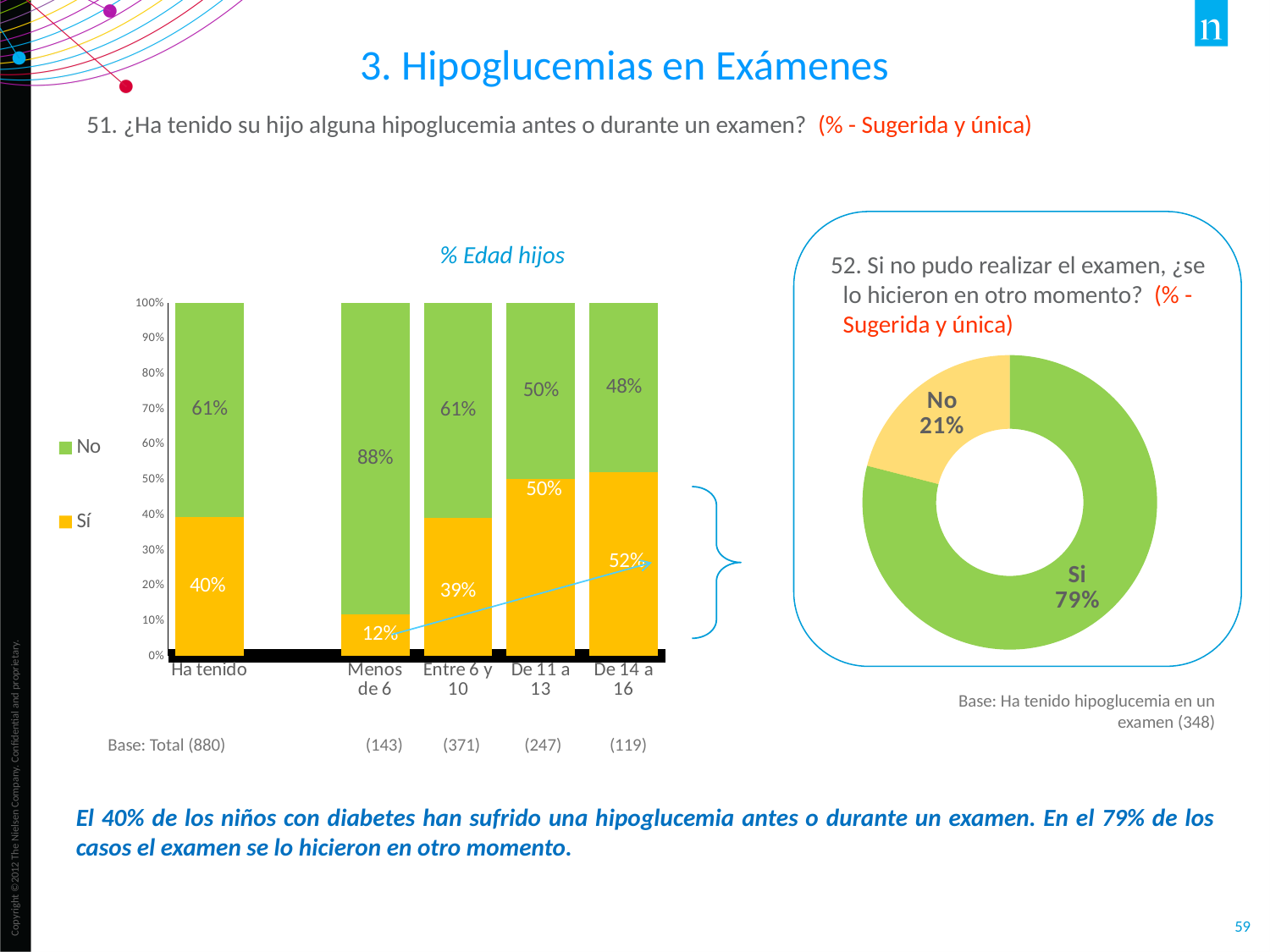
In the donut chart on the right, what share does 'Si' have? 79% In the stacked bar chart on the left, what is the difference between the 'Sí' values for 'De 14 a 16' and 'Menos de 6'? 40% In the stacked bar chart on the left, what is the 'No' value for 'Entre 6 y 10'? 61% In the stacked bar chart on the left, do the 'Sí' values rise or fall across the age groups from 'Menos de 6' to 'De 14 a 16'? rise In the stacked bar chart on the left, which age group has the lowest 'Sí' value? Menos de 6 In the stacked bar chart on the left, what is the 'Sí' value for 'Ha tenido'? 40% In the stacked bar chart on the left, what is the 'Sí' value for 'Menos de 6'? 12% In the stacked bar chart on the left, which is larger: the 'No' value for 'Menos de 6' or the 'No' value for 'De 11 a 13'? Menos de 6 In the stacked bar chart on the left, how many categories are shown on the x axis? 5 What kind of chart is the chart on the right? donut chart In the stacked bar chart on the left, which age group has the highest 'Sí' value? De 14 a 16 In the stacked bar chart on the left, how many series does the legend list? 2